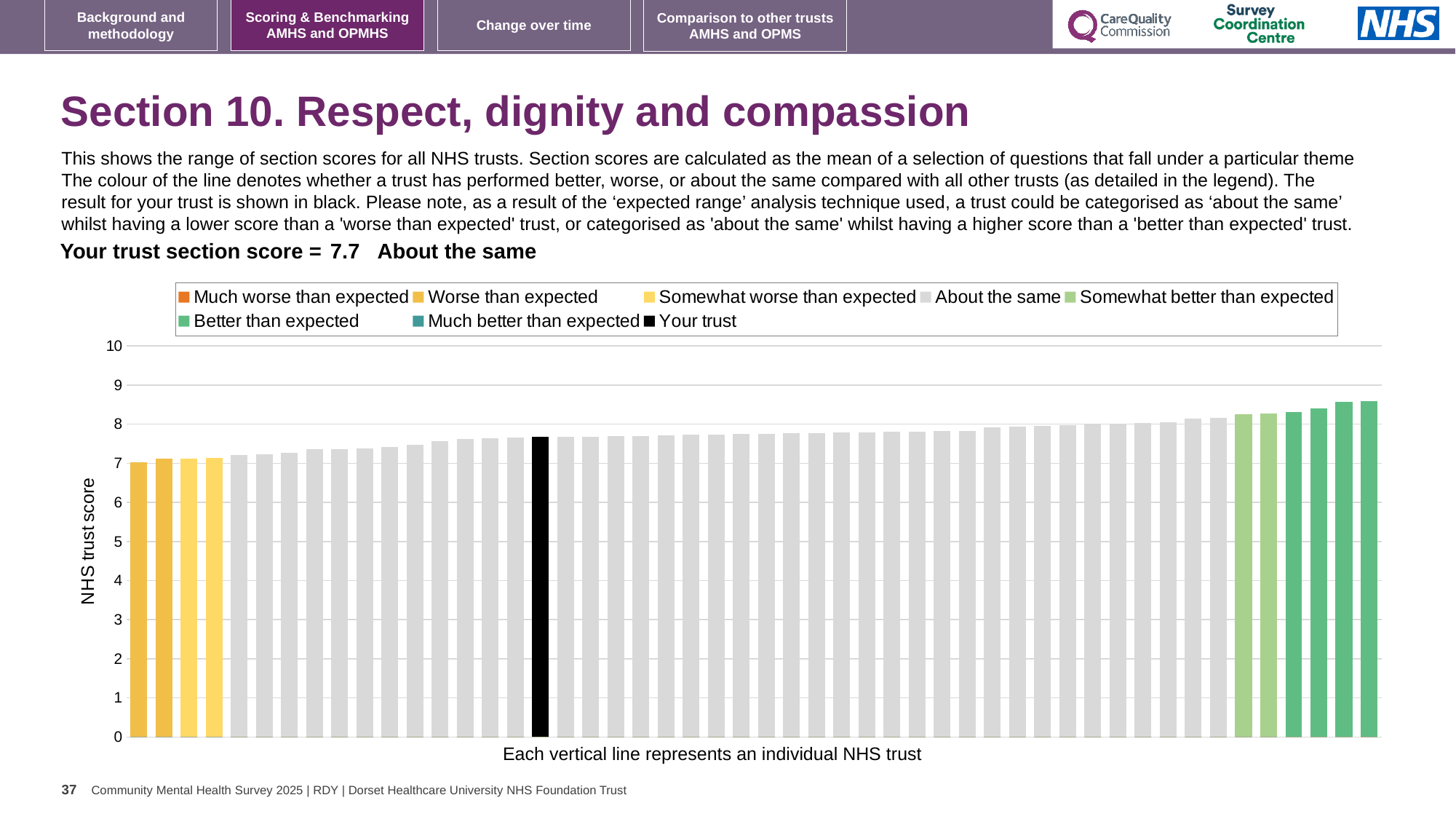
What colour is the bar representing your trust? black Which legend category do the highest bars on the chart belong to? Better than expected Is the value of the lowest bar on the chart greater or less than 8? less What is the section score for your trust shown on the chart? 7.7 How many bars on the chart are coloured yellow (worse or somewhat worse than expected)? 4 Which category is your trust's section score placed in? About the same What is the label on the vertical axis of the chart? NHS trust score What kind of chart is shown on the slide? bar chart Is the value for your trust greater or less than 7? greater Do the bar values rise or fall from left to right across the chart? rise Is the value of the highest bar on the chart greater or less than 8? greater How many entries does the chart legend list? 8